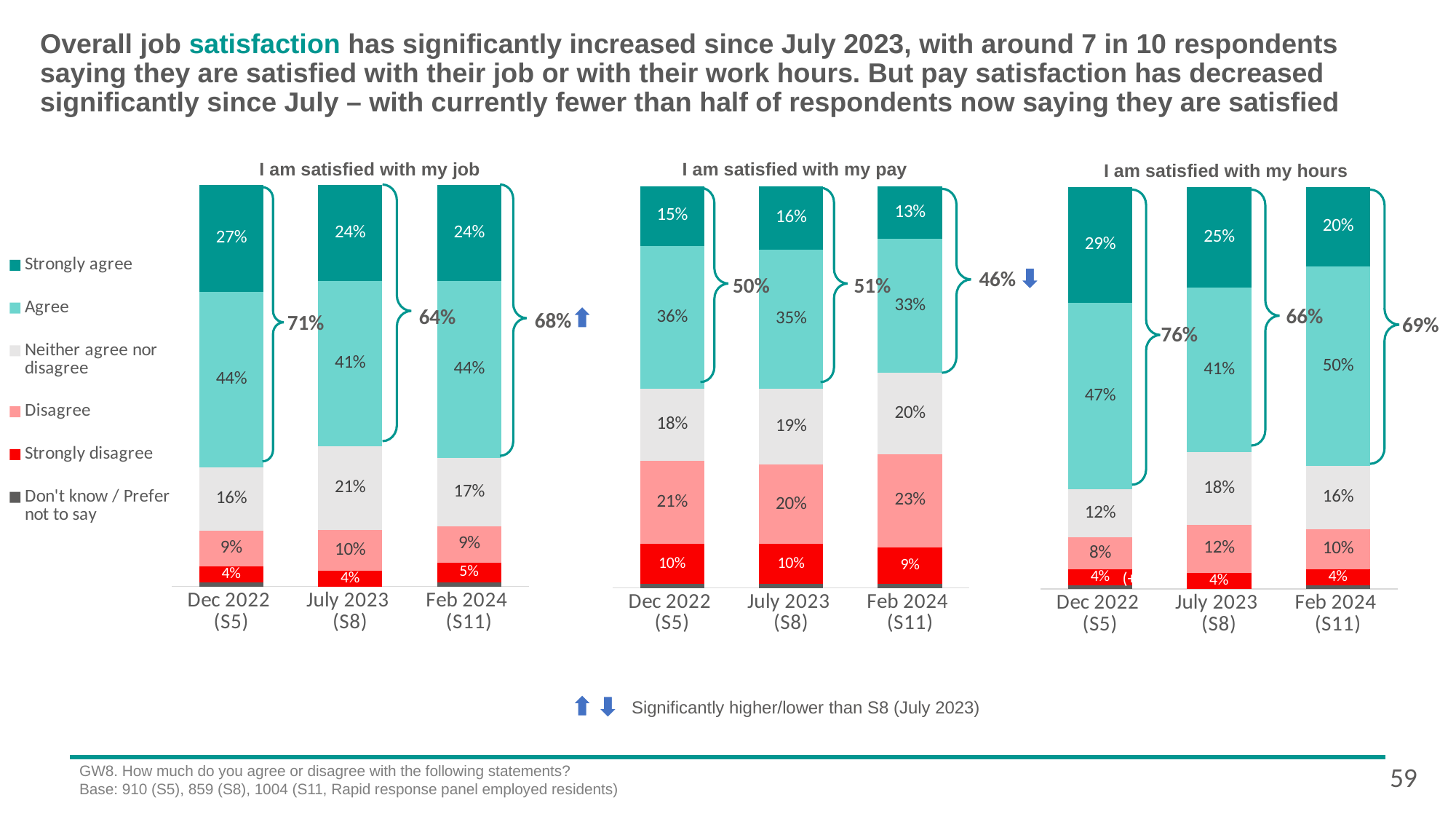
How many response categories does the legend list? 6 In the 'I am satisfied with my hours' chart, what is the total of 'Strongly agree' and 'Agree' for July 2023 (S8)? 66% In the 'I am satisfied with my hours' chart, what percentage agreed in Feb 2024 (S11)? 50% In the 'I am satisfied with my pay' chart, what percentage disagreed in Feb 2024 (S11)? 23% In the 'I am satisfied with my pay' chart, which is larger: the 'Agree' value for Dec 2022 (S5) or for Feb 2024 (S11)? Dec 2022 (S5) In the 'I am satisfied with my job' chart, what is the difference between the 'Neither agree nor disagree' values for July 2023 (S8) and Dec 2022 (S5)? 5 percentage points In the 'I am satisfied with my job' chart, what percentage strongly agreed in Dec 2022 (S5)? 27% In the 'I am satisfied with my job' chart, which wave has the lowest combined agree figure shown by the brackets? July 2023 (S8) In the 'I am satisfied with my pay' chart, what is the combined agree figure shown by the bracket for Feb 2024 (S11)? 46% What type of chart is used for 'I am satisfied with my pay'? Stacked bar chart In the 'I am satisfied with my hours' chart, which wave has the highest combined agree figure shown by the brackets? Dec 2022 (S5) How many waves (bars) are shown in the 'I am satisfied with my hours' chart? 3